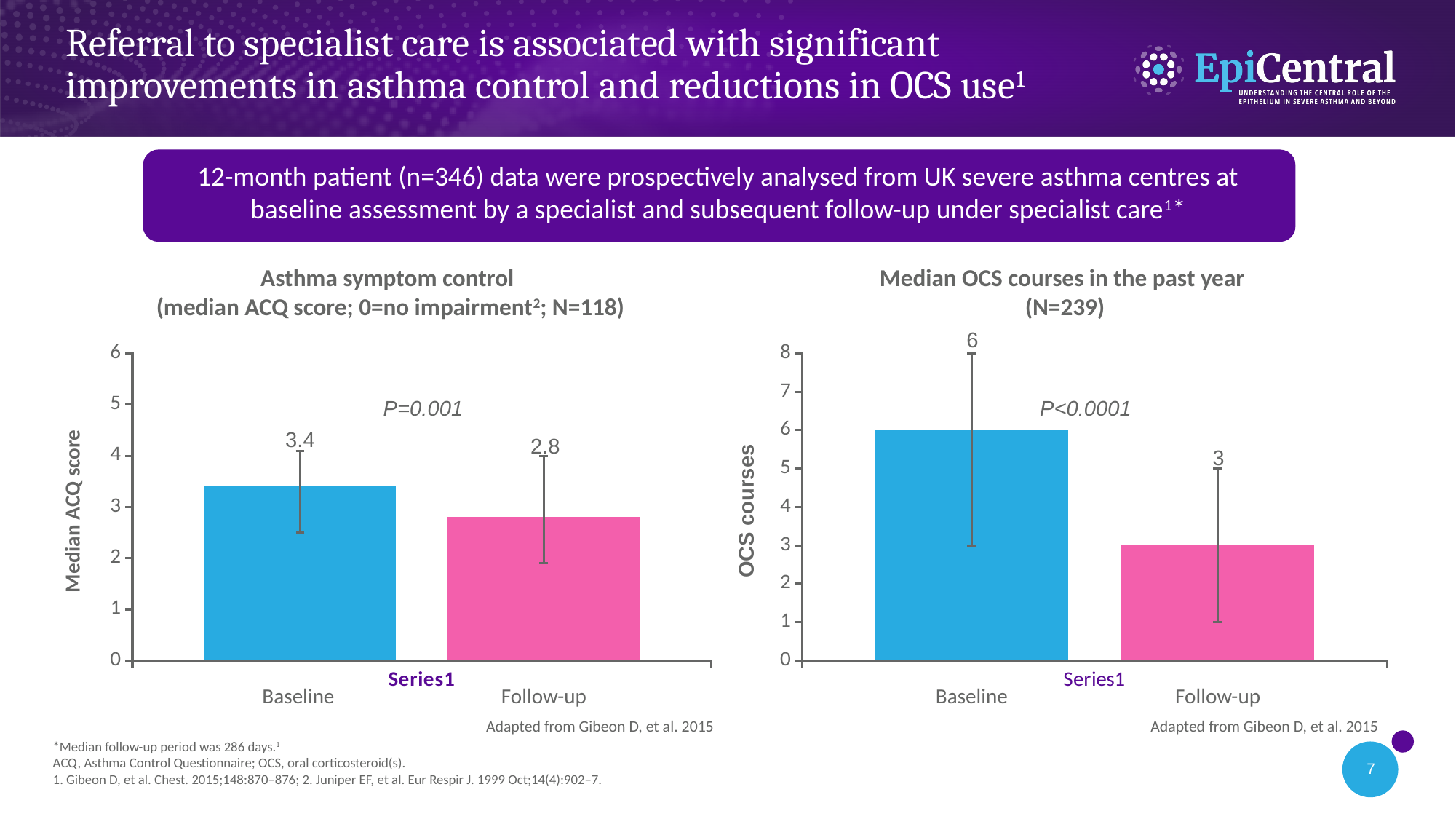
What kind of chart is the 'Median OCS courses in the past year' chart? Bar chart In the 'Asthma symptom control' chart, do the values rise or fall from Baseline to Follow-up? Fall What is the y-axis label of the 'Median OCS courses in the past year' chart? OCS courses In the 'Asthma symptom control' chart, which category has the lowest median ACQ score? Follow-up In the 'Asthma symptom control' chart, what is the median ACQ score at Follow-up? 2.8 In the 'Asthma symptom control' chart, what is the median ACQ score at Baseline? 3.4 In the 'Median OCS courses in the past year' chart, what is the value at Baseline? 6 How many categories are shown on the x axis of the 'Asthma symptom control' chart? 2 In the 'Asthma symptom control' chart, what is the difference between the Baseline and Follow-up median ACQ scores? 0.6 In the 'Median OCS courses in the past year' chart, what is the value at Follow-up? 3 In the 'Median OCS courses in the past year' chart, which category has the higher value, Baseline or Follow-up? Baseline In the 'Median OCS courses in the past year' chart, by how much did the median number of OCS courses fall from Baseline to Follow-up? 3